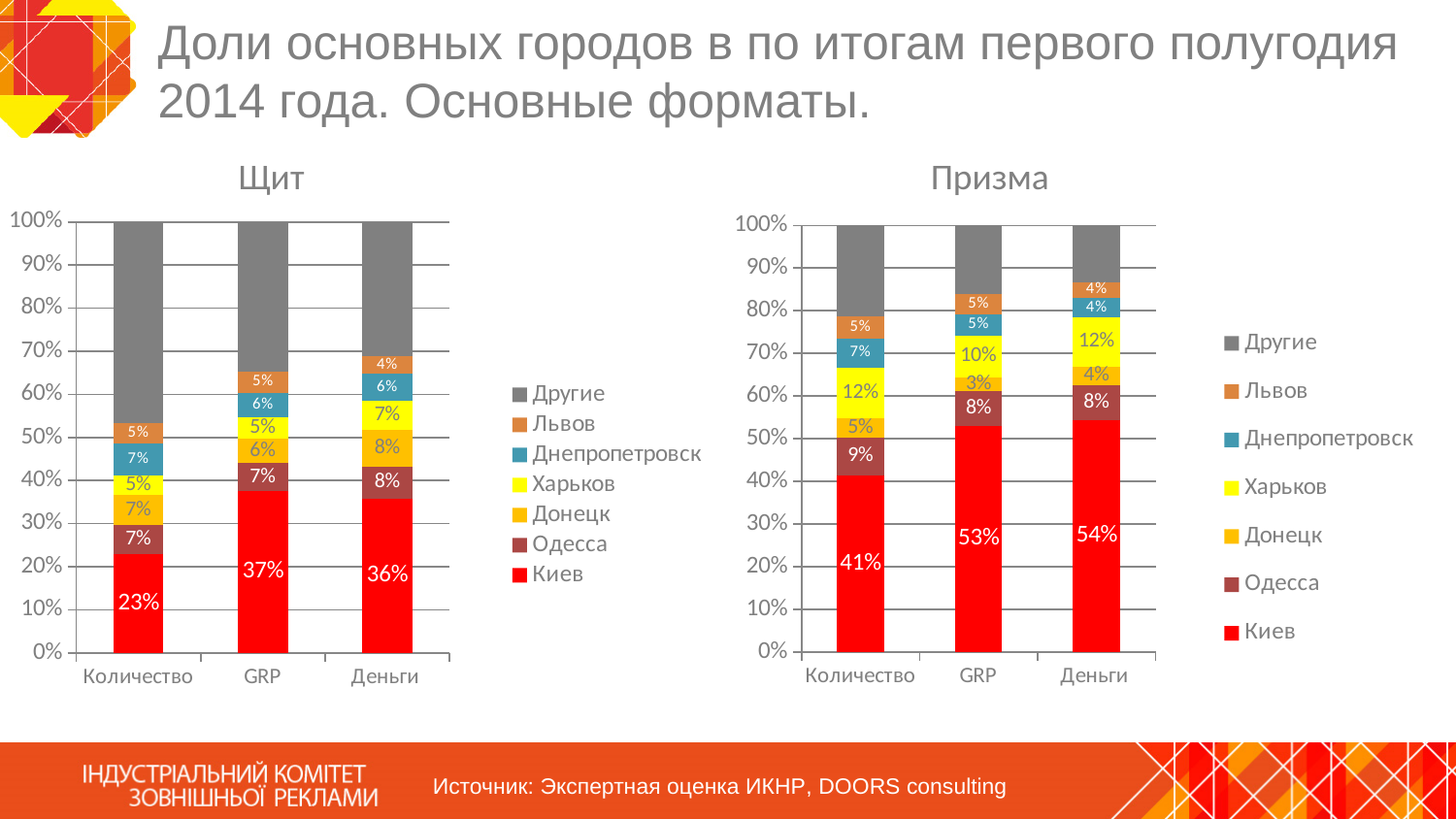
In the Щит chart, what is the value for Киев in the Количество bar? 23% In the Призма chart, is the Киев value for Количество greater or less than 50%? less How many series does the legend of the Призма chart list? 7 In the Щит chart, which category has the lowest value for Киев? Количество In the Щит chart, which is larger: the Киев value for GRP or for Деньги? GRP In the Призма chart, what is the difference between the Киев values for GRP and Количество? 12% In the Щит chart, what is the value for Киев in the GRP bar? 37% In the Призма chart, what is the value for Харьков in the Количество bar? 12% In the Призма chart, which category has the highest value for Киев? Деньги In the Призма chart, what is the value for Киев in the Деньги bar? 54% What type of chart is the Щит chart? Stacked bar chart How many categories are shown on the x axis of the Щит chart? 3